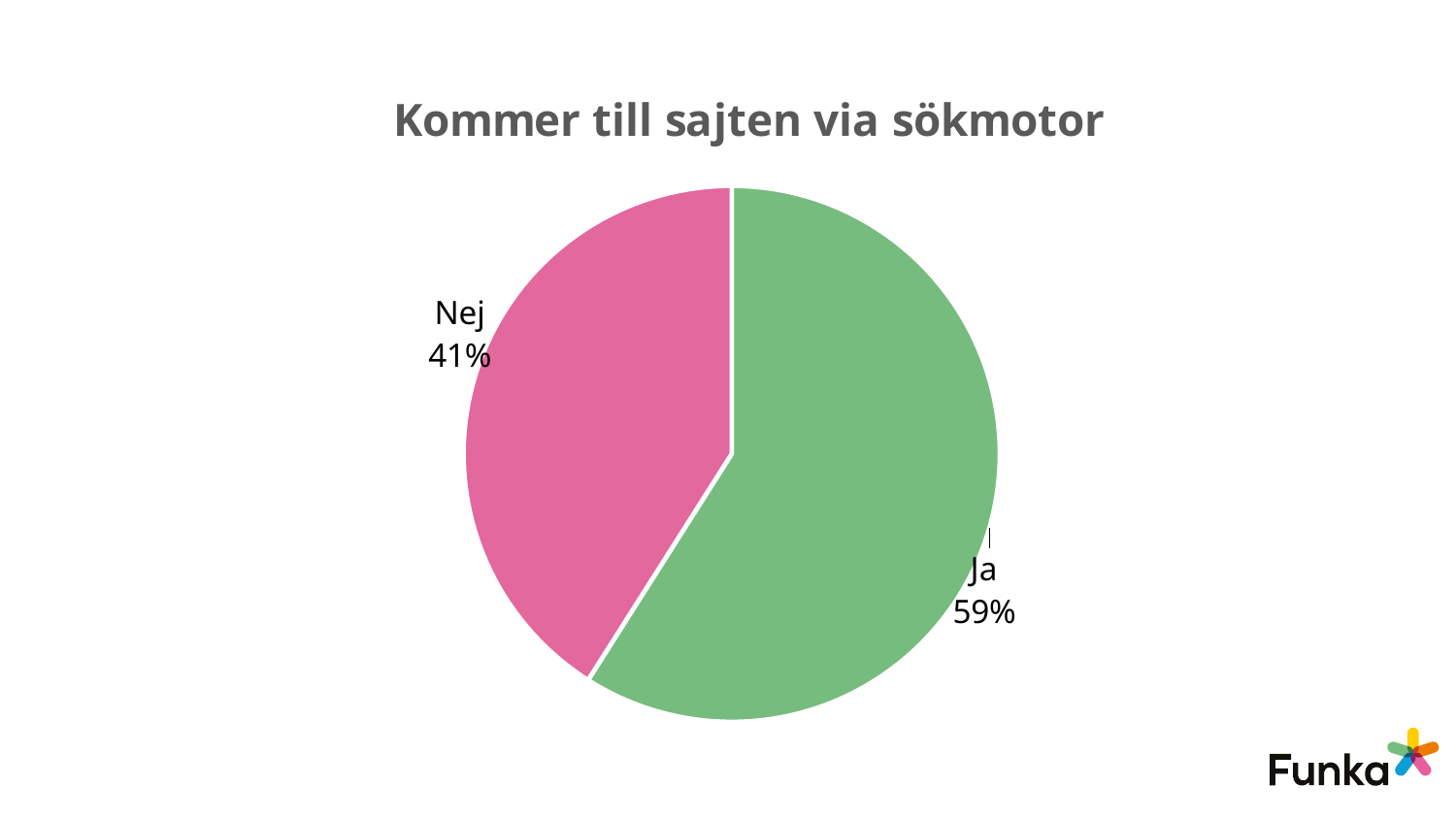
What colour is the "Nej" slice? pink Which is larger, the "Ja" slice or the "Nej" slice? Ja What is the total of the two slices shown? 100% What share of the pie does the "Ja" slice represent? 59% What kind of chart is shown on the slide? pie chart Is the value for "Ja" greater or less than 50%? greater What is the title of the chart? Kommer till sajten via sökmotor What is the difference in percentage points between the "Ja" and "Nej" slices? 18 How many slices does the pie chart have? 2 Which slice is the largest? Ja What share of the pie does the "Nej" slice represent? 41% Which slice is the smallest? Nej